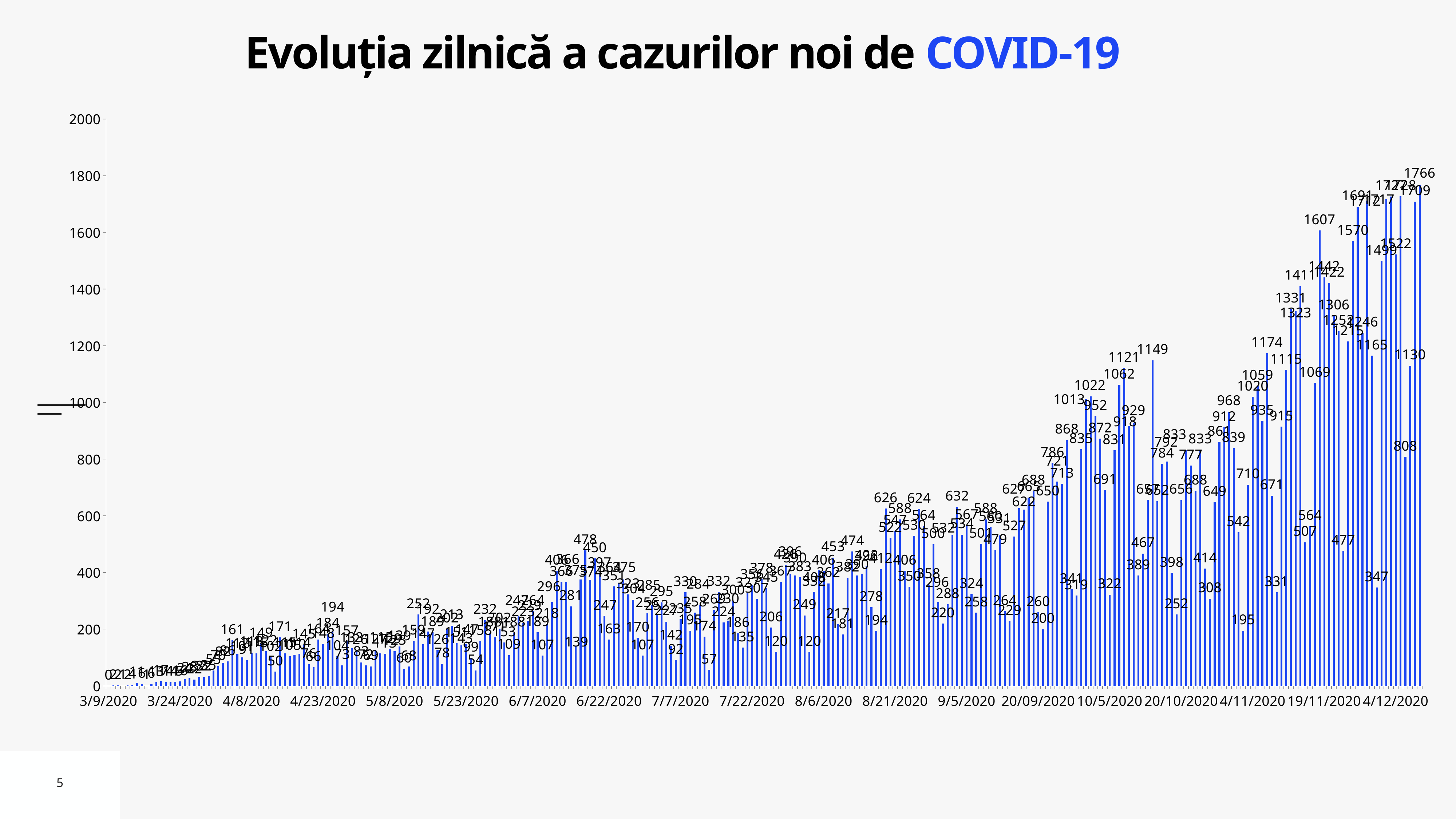
Is the value for 5/8/2020 greater or less than 1000? less Do the daily values generally rise or fall from 3/9/2020 to 4/12/2020? rise What is the maximum value shown on the vertical axis? 2000 What is the title of the chart? Evoluția zilnică a cazurilor noi de COVID-19 Is the value for 6/22/2020 greater or less than 1000? less Is the value for 9/5/2020 greater or less than 1200? less What kind of chart is shown on the slide? bar chart What is the lowest value labeled on the chart, at the start of the series? 0 Which date has the larger value, 3/24/2020 or 4/12/2020? 4/12/2020 What is the highest value labeled on the chart? 1766